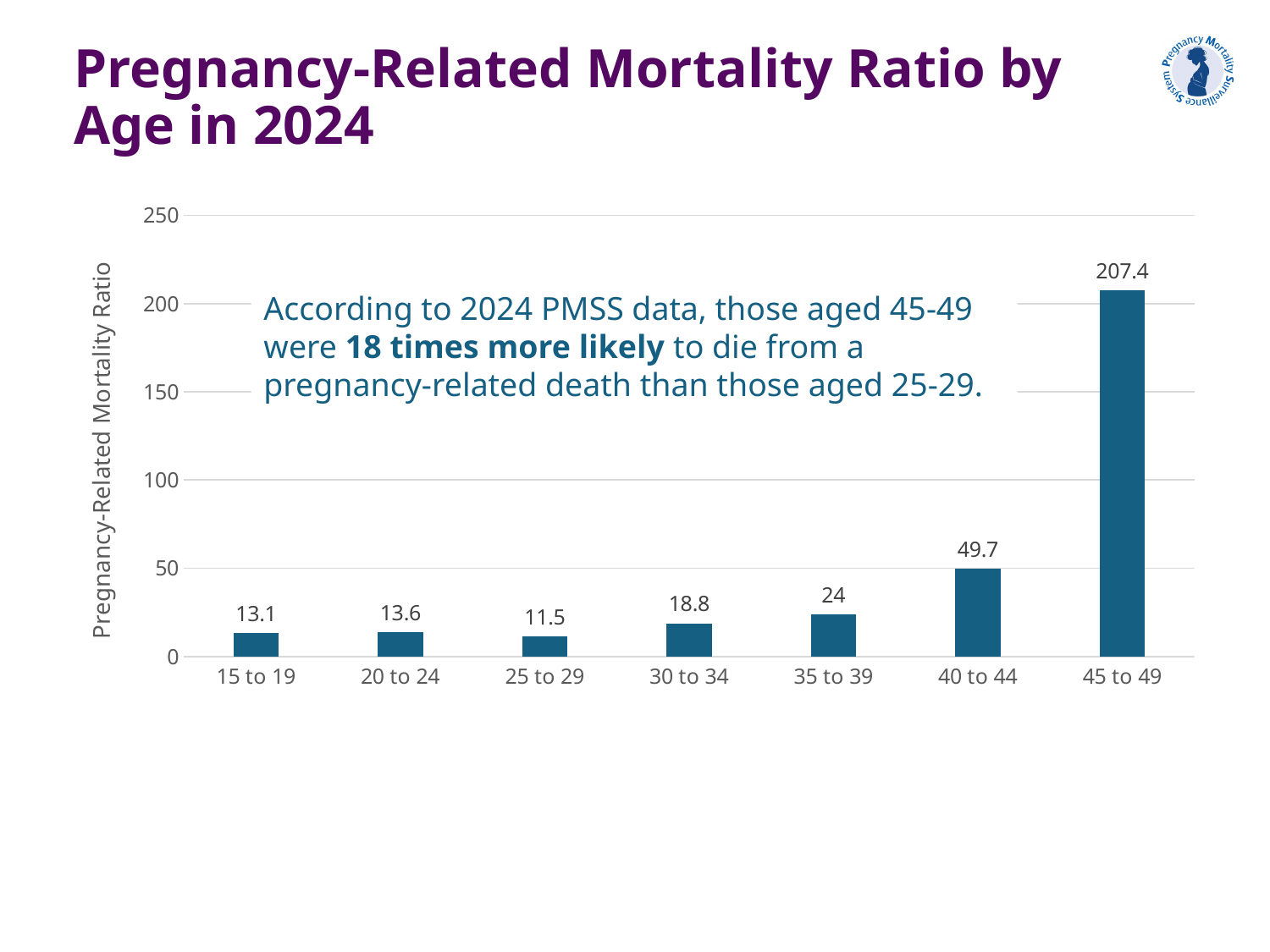
Which age group has the lowest pregnancy-related mortality ratio? 25 to 29 What is the pregnancy-related mortality ratio for the 25 to 29 age group? 11.5 What is the pregnancy-related mortality ratio for the 40 to 44 age group? 49.7 Is the value for 45 to 49 greater or less than 200? greater What is the pregnancy-related mortality ratio for the 45 to 49 age group? 207.4 Which age group has a higher mortality ratio, 20 to 24 or 30 to 34? 30 to 34 What kind of chart is shown on the slide? Bar chart Which age group has the highest pregnancy-related mortality ratio? 45 to 49 How many age groups are shown on the chart? 7 What is the difference between the mortality ratio for 45 to 49 and for 40 to 44? 157.7 What is the label on the vertical axis of the chart? Pregnancy-Related Mortality Ratio What is the difference between the mortality ratio for 35 to 39 and for 30 to 34? 5.2